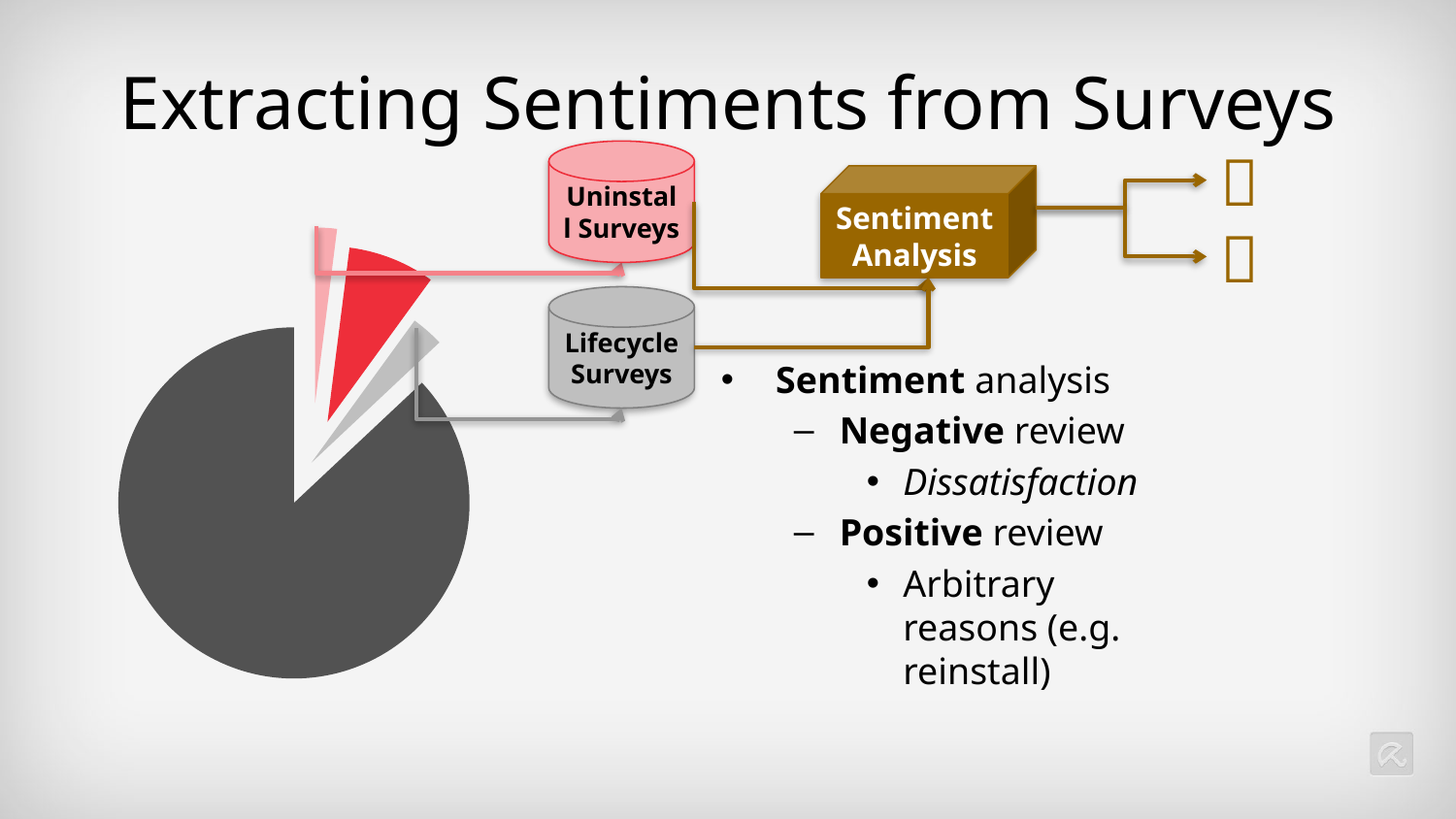
What kind of chart is shown on the left of the slide? pie chart Which colour slice of the pie chart is the largest? dark grey Does the pie chart on the slide have a legend? No Does the pie chart show any data labels with values? No In the pie chart, which is larger: the dark grey slice or the red slice? the dark grey slice In the pie chart, which is larger: the red slice or the light pink slice? the red slice